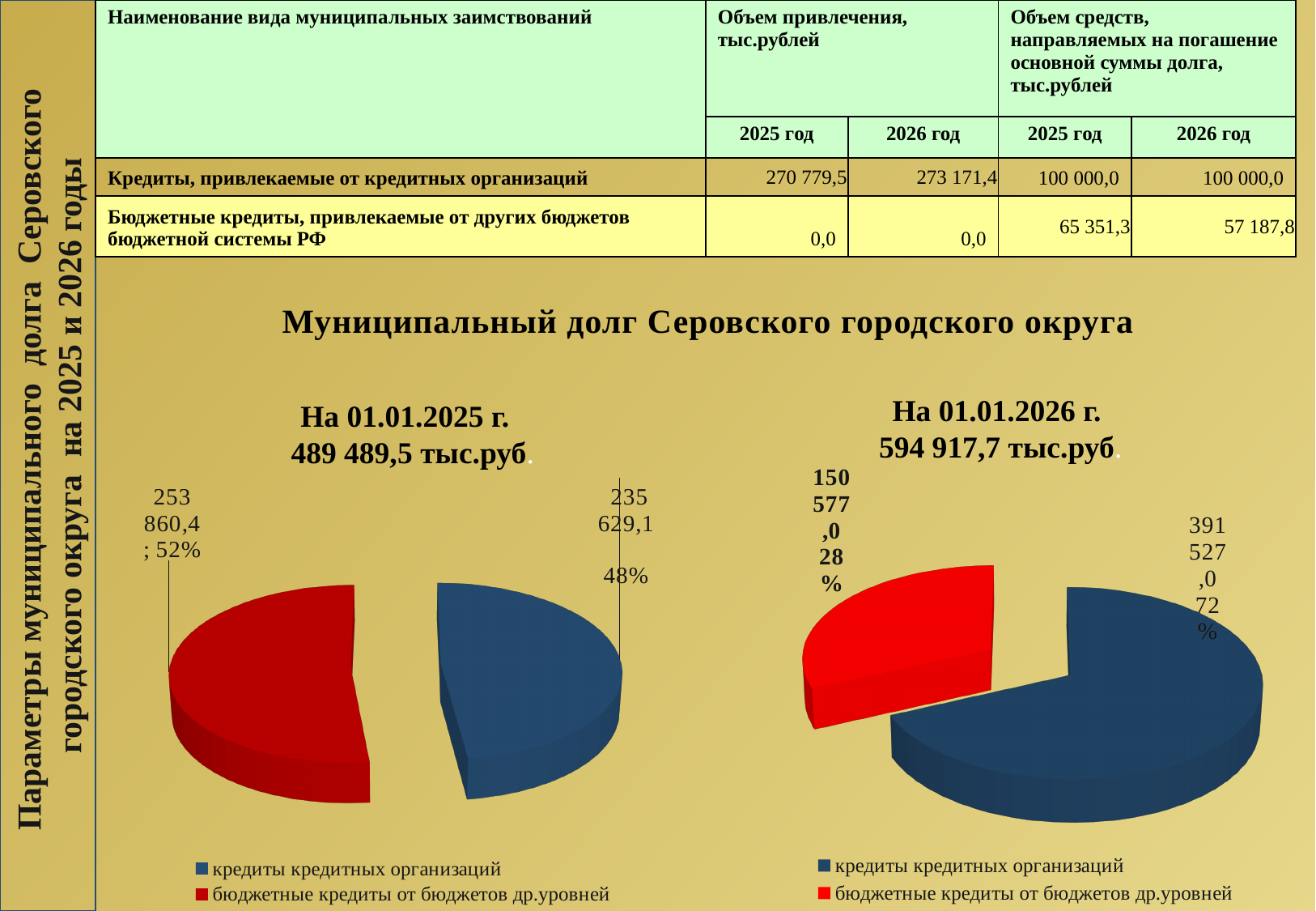
How many slices does the pie chart 'На 01.01.2025 г.' have? 2 In the pie chart 'На 01.01.2025 г.', what is the value for 'бюджетные кредиты от бюджетов др.уровней'? 253 860,4 In the pie chart 'На 01.01.2025 г.', what is the value for 'кредиты кредитных организаций'? 235 629,1 In the pie chart 'На 01.01.2026 г.', which is larger: 'кредиты кредитных организаций' or 'бюджетные кредиты от бюджетов др.уровней'? кредиты кредитных организаций In the pie chart 'На 01.01.2026 г.', which category has the largest slice? кредиты кредитных организаций What type of chart is used on the slide for the municipal debt data? pie chart In the pie chart 'На 01.01.2026 г.', what is the value for 'бюджетные кредиты от бюджетов др.уровней'? 150 577,0 In the pie chart 'На 01.01.2026 г.', what is the value for 'кредиты кредитных организаций'? 391 527,0 In the pie chart 'На 01.01.2026 г.', which category has the smallest slice? бюджетные кредиты от бюджетов др.уровней What total amount is stated in the subtitle of the pie chart 'На 01.01.2026 г.'? 594 917,7 тыс.руб. In the pie chart 'На 01.01.2025 г.', what share does 'бюджетные кредиты от бюджетов др.уровней' have? 52% In the pie chart 'На 01.01.2026 г.', what share does 'кредиты кредитных организаций' have? 72%